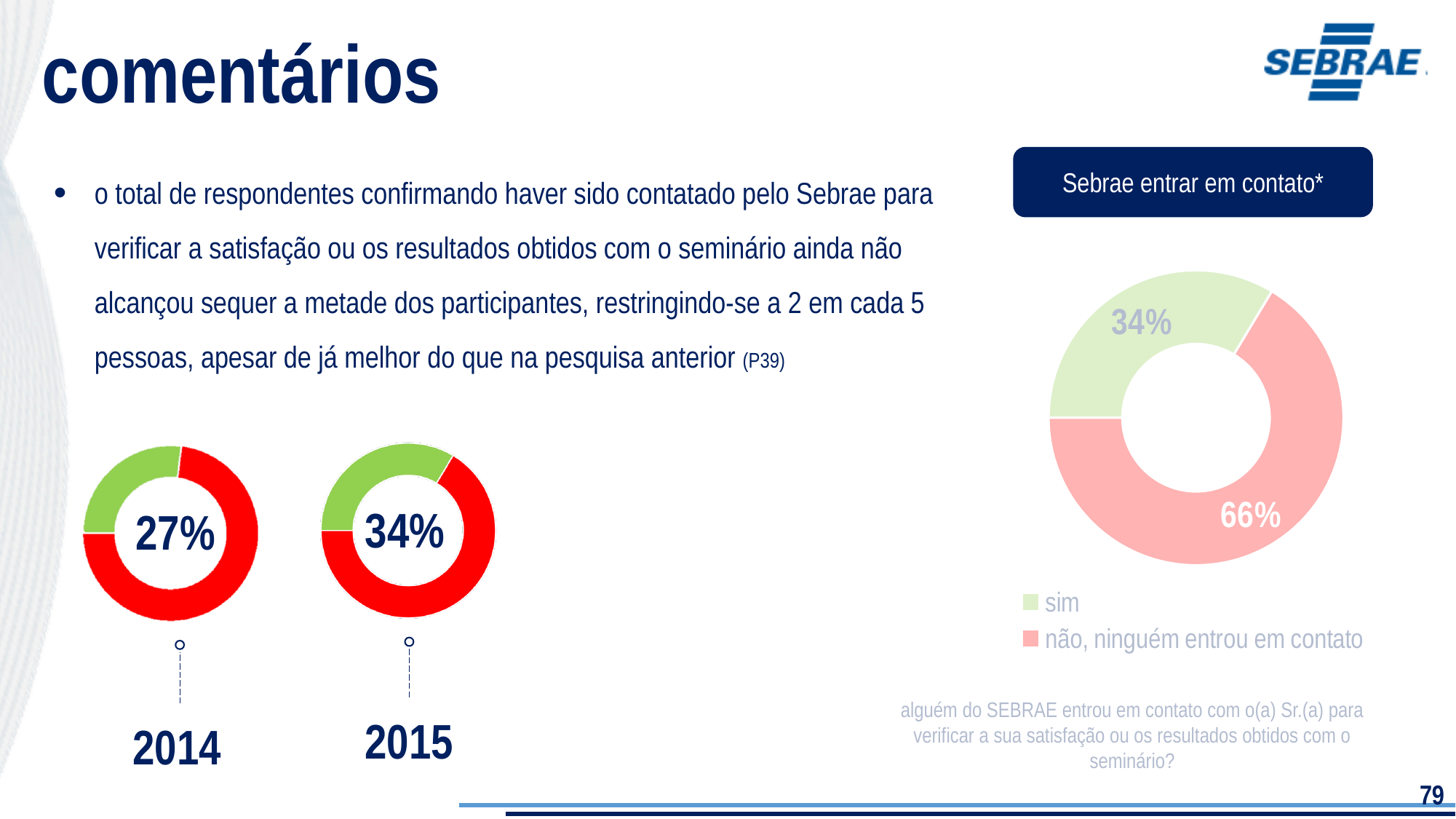
In the small donut chart labelled 2015 at the bottom left, what percentage is shown in the centre? 34% In the small donut chart labelled 2014 at the bottom left, what percentage is shown in the centre? 27% In the chart titled "Sebrae entrar em contato*", what percentage is shown for "não, ninguém entrou em contato"? 66% In the chart titled "Sebrae entrar em contato*", which category has the smallest share? sim Comparing the small donut charts at the bottom left, which year shows the higher percentage, 2014 or 2015? 2015 In the chart titled "Sebrae entrar em contato*", which category has the largest share? não, ninguém entrou em contato In the chart titled "Sebrae entrar em contato*", what is the difference in percentage points between "não, ninguém entrou em contato" and "sim"? 32 In the chart titled "Sebrae entrar em contato*", what colour represents "sim"? Light green What kind of chart is the one titled "Sebrae entrar em contato*"? Donut (pie) chart In the chart titled "Sebrae entrar em contato*", what percentage is shown for "sim"? 34% Comparing the small donut charts at the bottom left, by how many percentage points did the value rise from 2014 to 2015? 7 In the chart titled "Sebrae entrar em contato*", how many categories does the legend list? 2